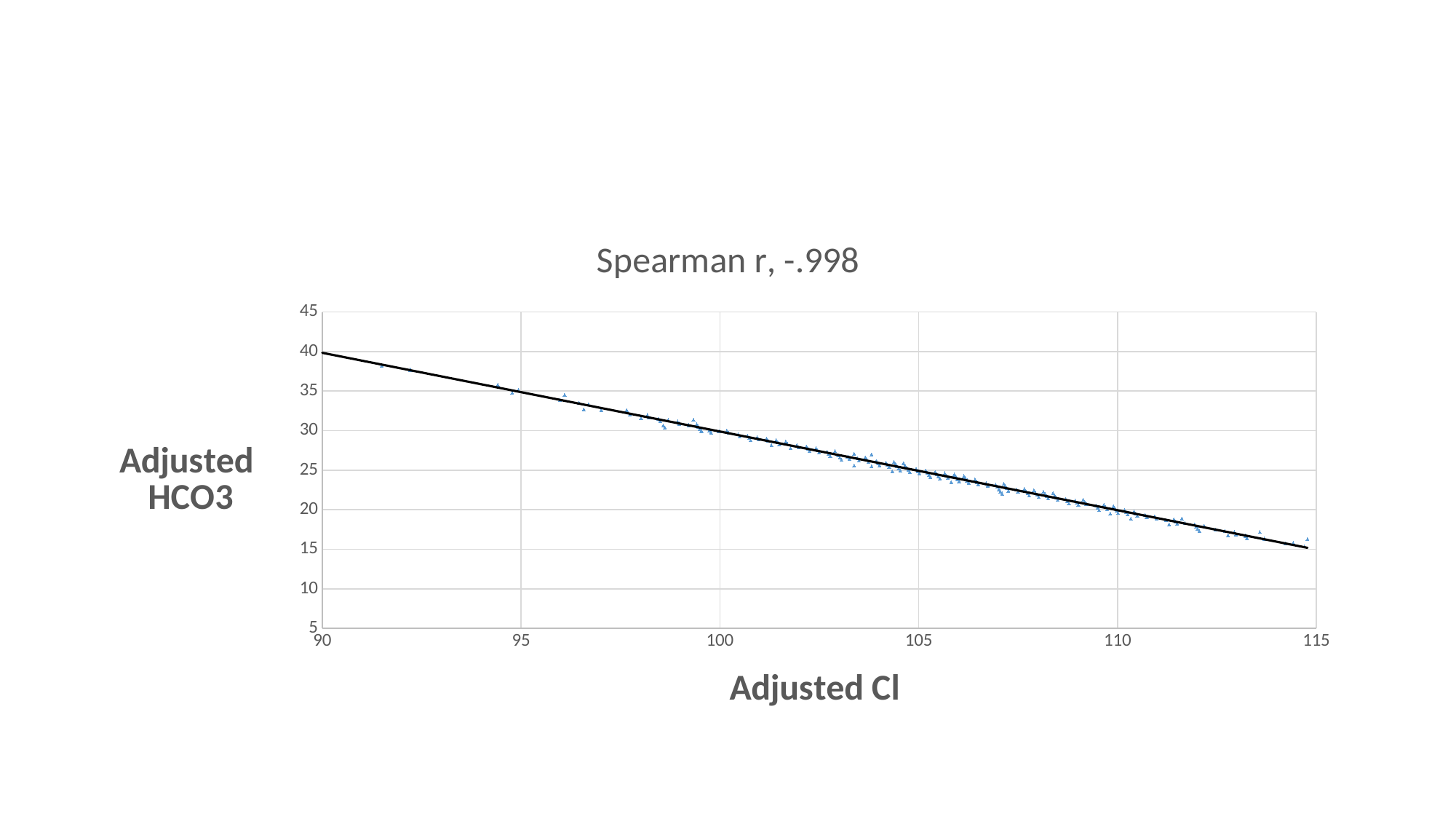
Is the Adjusted HCO3 value at an Adjusted Cl of 100 greater or less than 35? less Is the Adjusted HCO3 value at an Adjusted Cl of 105 greater or less than 20? greater What is the label of the x axis? Adjusted Cl What kind of chart is shown on the slide? scatter chart Is the Adjusted HCO3 value at an Adjusted Cl of 115 greater or less than 20? less Which has the higher Adjusted HCO3 value: the point at an Adjusted Cl of 95 or the point at an Adjusted Cl of 110? the point at an Adjusted Cl of 95 What is the title of the chart? Spearman r, -.998 Do the Adjusted HCO3 values rise or fall as Adjusted Cl increases along the x axis? fall